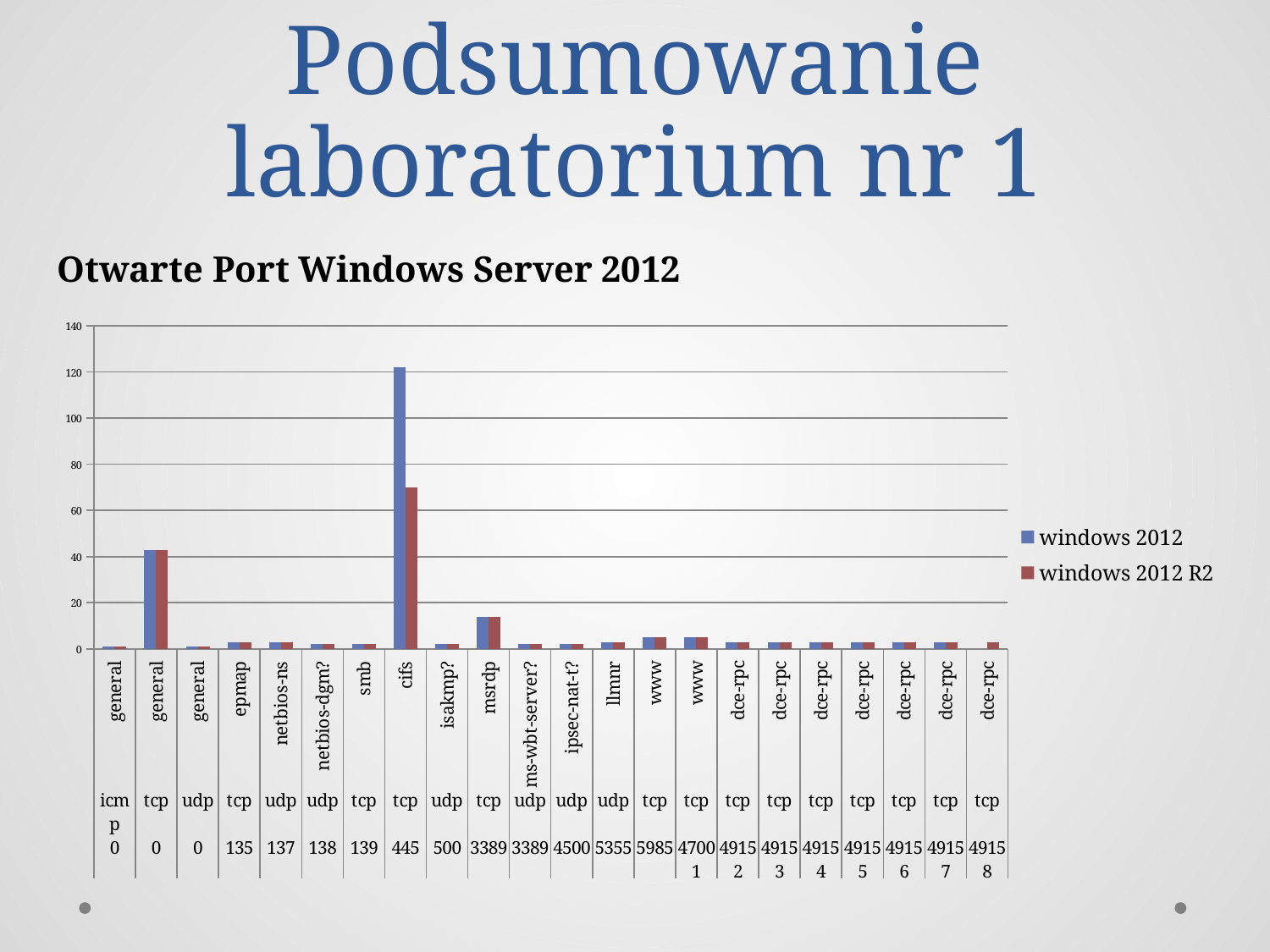
Is the windows 2012 value for cifs (tcp 445) greater or less than 100? greater For cifs (tcp 445), which series has the larger value, windows 2012 or windows 2012 R2? windows 2012 Which is larger for the windows 2012 series: the value for cifs (tcp 445) or the value for msrdp (tcp 3389)? cifs (tcp 445) Which category has the highest value for the windows 2012 series? cifs (tcp 445) Is the windows 2012 R2 value for cifs (tcp 445) greater or less than 80? less What are the two series named in the legend? windows 2012 and windows 2012 R2 Which category has the highest value for the windows 2012 R2 series? cifs (tcp 445) What is the title of the chart? Otwarte Port Windows Server 2012 Is the windows 2012 value for msrdp (tcp 3389) greater or less than 20? less How many series does the legend list? 2 What kind of chart is shown on the slide? bar chart